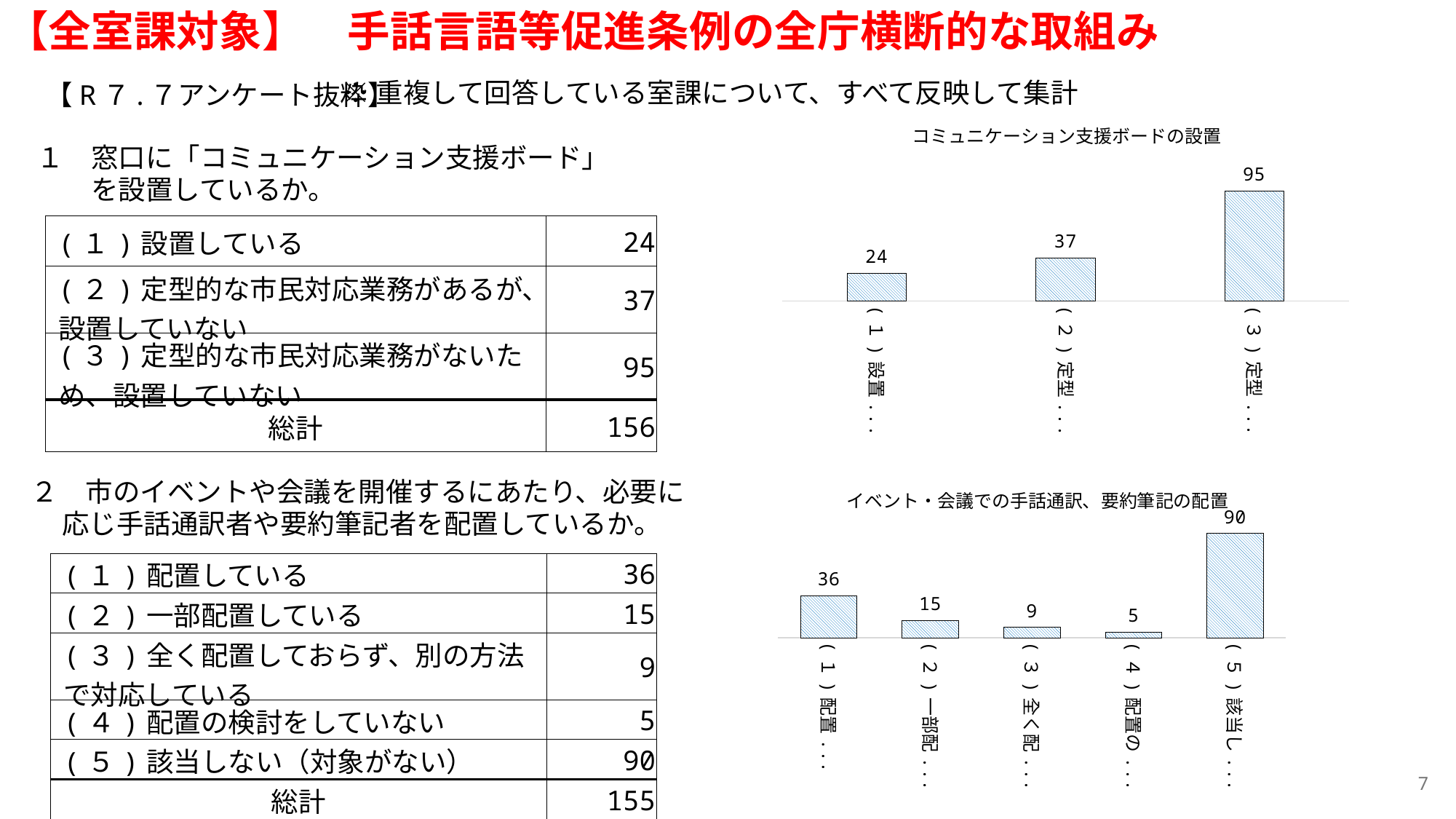
In the chart titled コミュニケーション支援ボードの設置, what is the difference between the values for category (3) and category (2)? 58 In the chart titled イベント・会議での手話通訳、要約筆記の配置, what is the value for category (2)? 15 In the chart titled コミュニケーション支援ボードの設置, how many bars are plotted? 3 In the chart titled コミュニケーション支援ボードの設置, which category has the highest value? (3) In the chart titled コミュニケーション支援ボードの設置, what is the value for category (1)? 24 What kind of chart is the chart titled コミュニケーション支援ボードの設置? bar chart In the chart titled イベント・会議での手話通訳、要約筆記の配置, which is larger, the value for category (1) or category (3)? (1) In the chart titled イベント・会議での手話通訳、要約筆記の配置, what is the value for category (5)? 90 In the chart titled イベント・会議での手話通訳、要約筆記の配置, what is the difference between the values for category (1) and category (2)? 21 What is the title of the lower chart on the slide? イベント・会議での手話通訳、要約筆記の配置 In the chart titled イベント・会議での手話通訳、要約筆記の配置, which category has the lowest value? (4) In the chart titled イベント・会議での手話通訳、要約筆記の配置, how many categories are plotted? 5